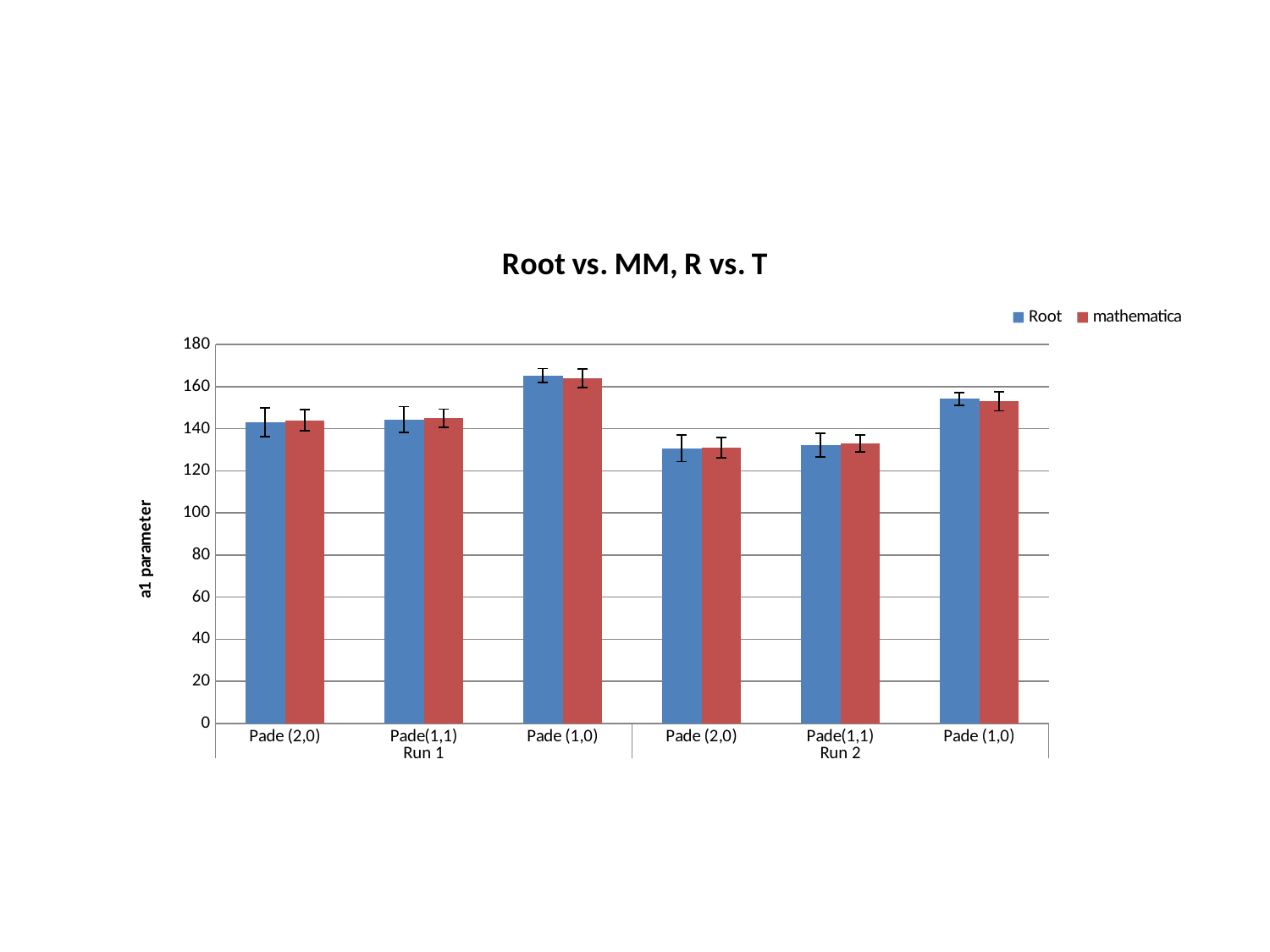
Which category has the highest Root value? Pade (1,0) in Run 1 What is the label on the vertical axis? a1 parameter Is the mathematica value for Pade (1,0) in Run 2 greater or less than 140? greater Which category has the highest mathematica value? Pade (1,0) in Run 1 What kind of chart is shown on the slide? bar chart Is the Root value for Pade (2,0) in Run 2 greater or less than 140? less How many series does the legend list? 2 Is the Root value for Pade (1,0) in Run 1 greater or less than 160? greater What is the title of the chart? Root vs. MM, R vs. T How many category groups are plotted along the x axis? 6